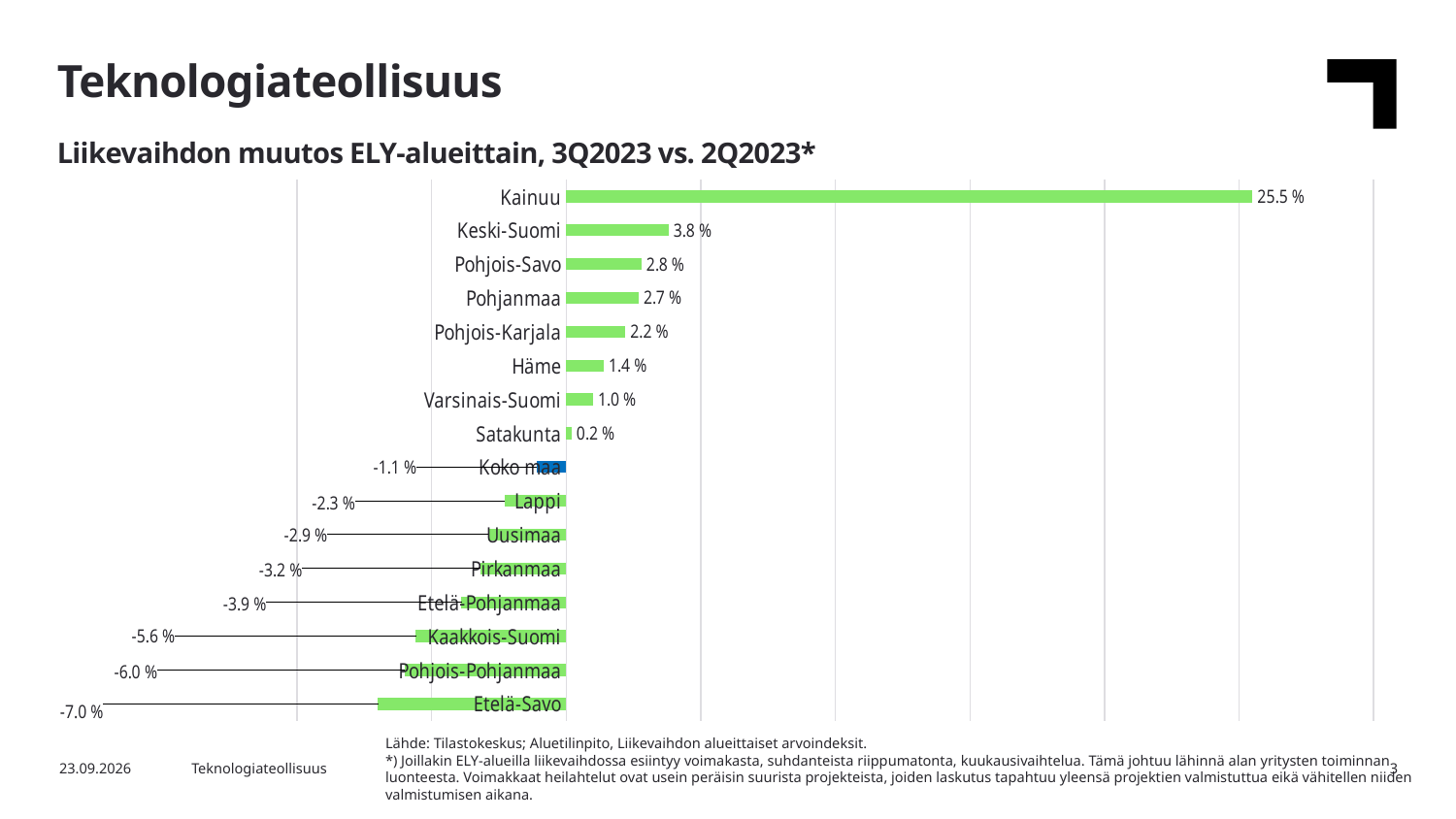
What is the value for Kainuu? 25.5 % Which has the larger value, Häme or Varsinais-Suomi? Häme What is the difference between the values for Keski-Suomi and Pohjois-Savo? 1.0 % What is the value for Etelä-Savo? -7.0 % What is the title of the chart? Liikevaihdon muutos ELY-alueittain, 3Q2023 vs. 2Q2023* What is the value for Koko maa? -1.1 % Which region has the lowest value? Etelä-Savo How many categories are shown in the chart? 16 Which region has the highest value? Kainuu Which has the larger value, Lappi or Uusimaa? Lappi What is the value for Satakunta? 0.2 % What kind of chart is shown on the slide? Bar chart